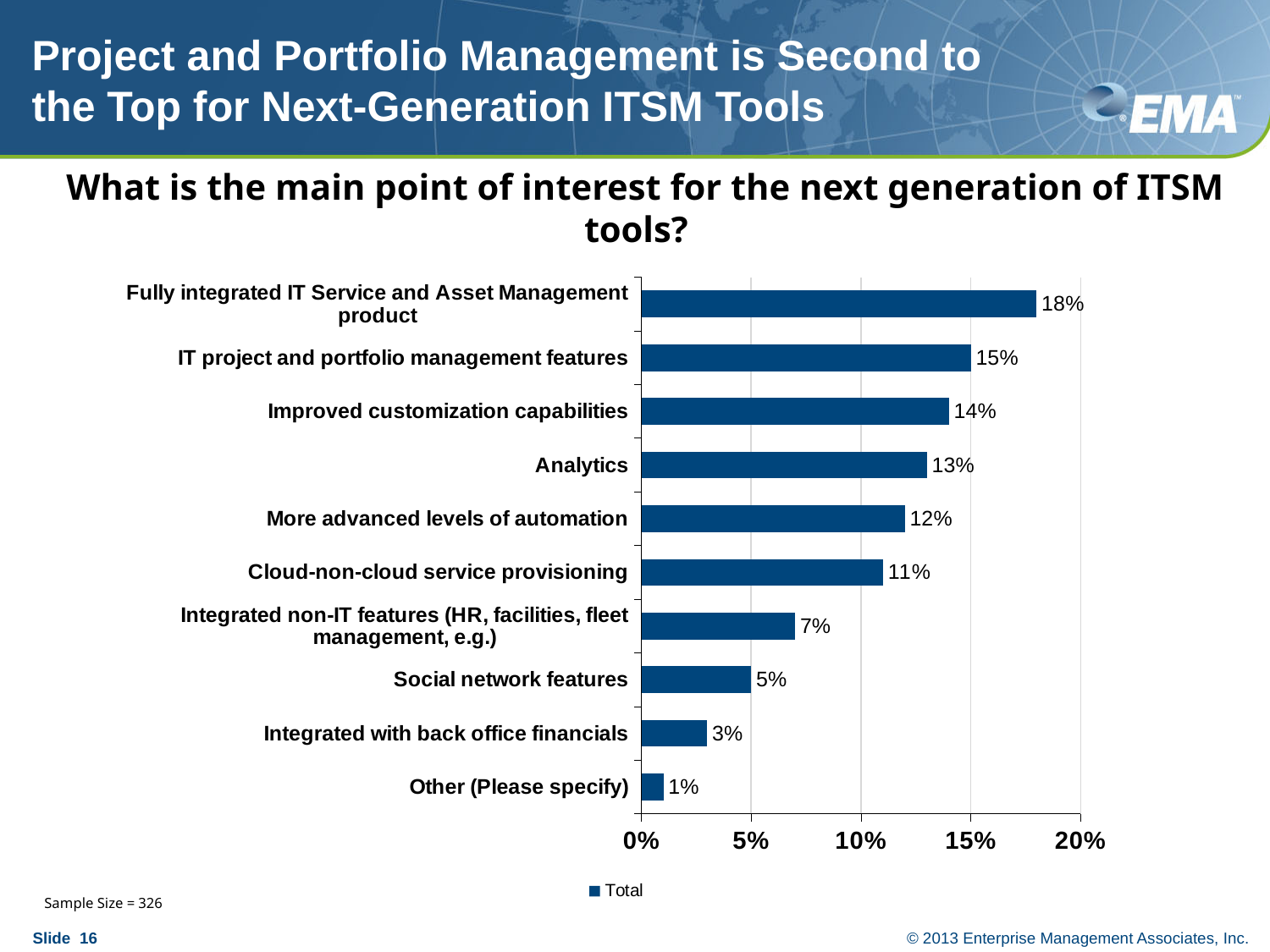
What is the value for IT project and portfolio management features? 15% How many categories are shown in the chart? 10 What is the value for Analytics? 13% What kind of chart is shown on the slide? bar chart Is the value for Integrated non-IT features (HR, facilities, fleet management, e.g.) greater or less than 10%? less How many series does the legend list? 1 Which is larger: the value for Improved customization capabilities or the value for More advanced levels of automation? Improved customization capabilities What is the value for Social network features? 5% What is the difference between the values for Fully integrated IT Service and Asset Management product and Cloud-non-cloud service provisioning? 7% What is the title of the chart? What is the main point of interest for the next generation of ITSM tools? Which category has the highest value? Fully integrated IT Service and Asset Management product Which category has the lowest value? Other (Please specify)